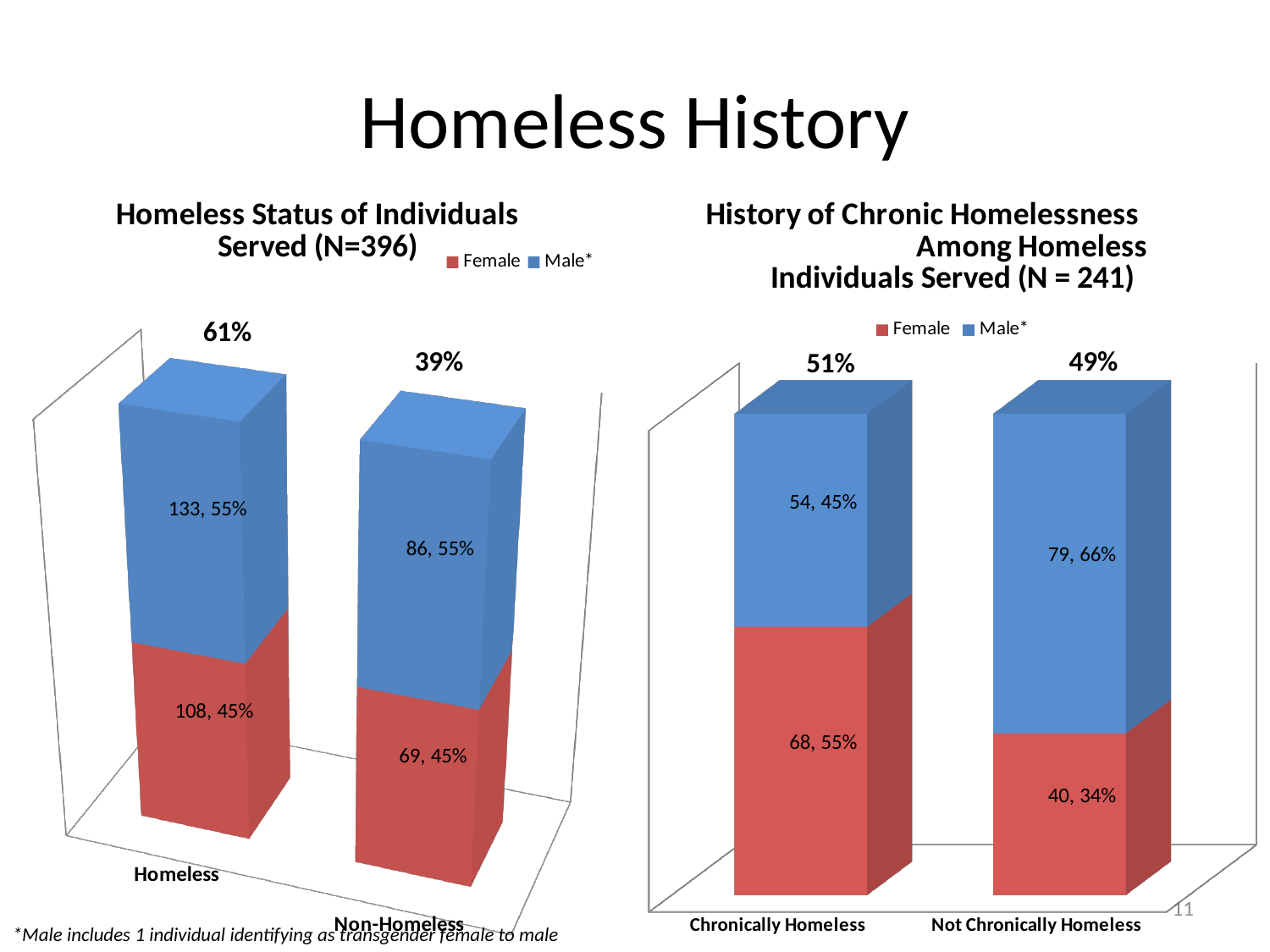
In the left chart (Homeless Status of Individuals Served), what is the data label for Male* in the Homeless bar? 133, 55% In the right chart (History of Chronic Homelessness), which category has the larger Female count, Chronically Homeless or Not Chronically Homeless? Chronically Homeless In the right chart (History of Chronic Homelessness), what is the data label for Female in the Not Chronically Homeless bar? 40, 34% In the left chart (Homeless Status of Individuals Served), what percentage is shown above the Homeless bar? 61% In the left chart (Homeless Status of Individuals Served), how many Female individuals are in the Non-Homeless bar? 69 In the right chart (History of Chronic Homelessness), how many Male* individuals are in the Chronically Homeless bar? 54 In the left chart (Homeless Status of Individuals Served), what is the difference between the Male* count for Homeless and the Male* count for Non-Homeless? 47 In the right chart (History of Chronic Homelessness), what is the total count of the Not Chronically Homeless stacked bar (Female plus Male*)? 119 In the right chart (History of Chronic Homelessness), what percentage is shown above the Chronically Homeless bar? 51% What kind of chart is the right chart (History of Chronic Homelessness)? Stacked bar chart How many series does the legend of the left chart (Homeless Status of Individuals Served) list? 2 In the left chart (Homeless Status of Individuals Served), what is the total count of the Homeless stacked bar (Female plus Male*)? 241